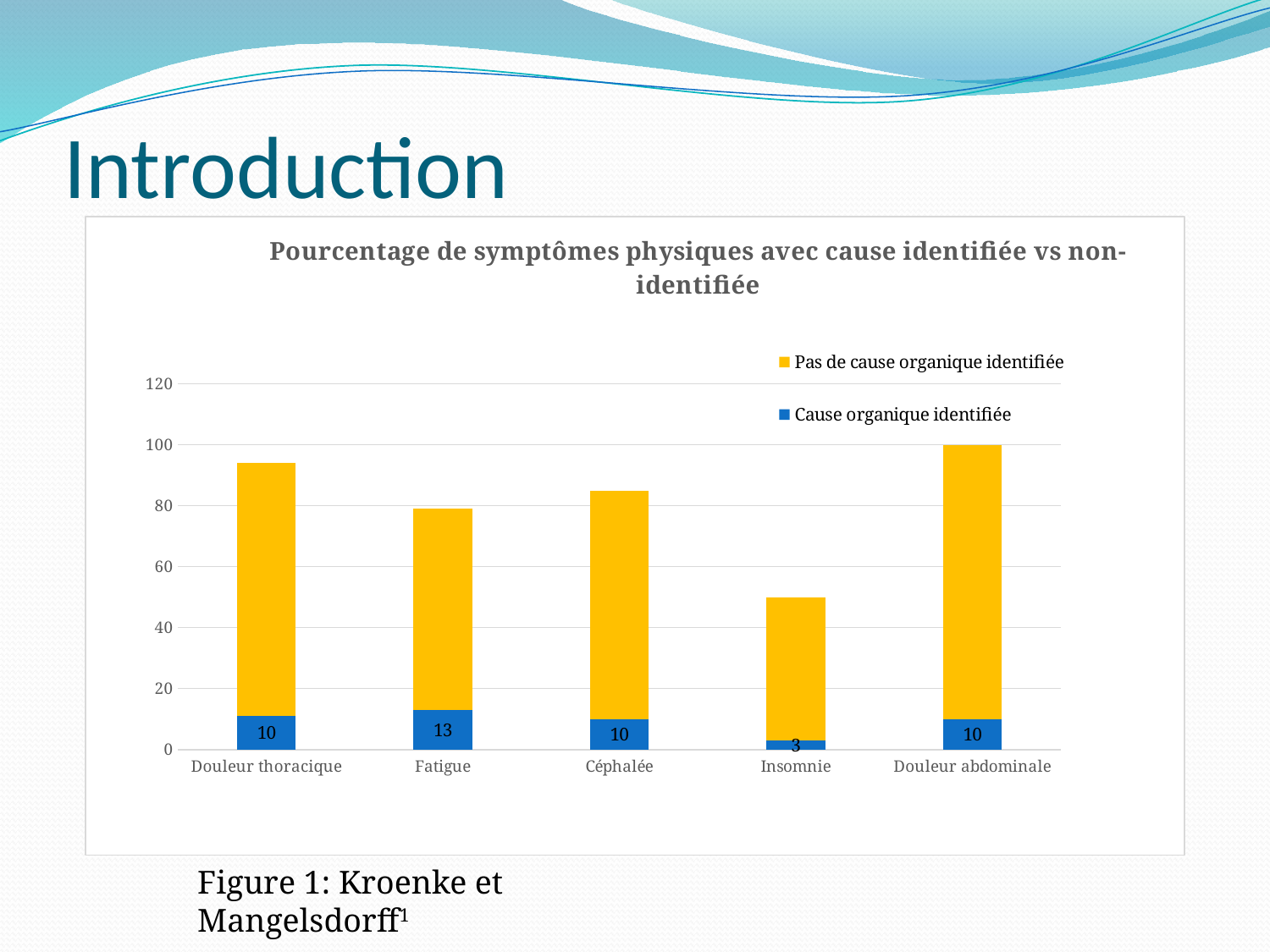
Is the total height of the stacked bar for Insomnie greater or less than 60? less Is the total height of the stacked bar for Douleur thoracique greater or less than 80? greater Which category has the highest value for 'Cause organique identifiée'? Fatigue What is the value of 'Cause organique identifiée' for Fatigue? 13 Which has the larger 'Cause organique identifiée' value, Fatigue or Céphalée? Fatigue What is the value of 'Cause organique identifiée' for Insomnie? 3 What is the difference between the 'Cause organique identifiée' values for Fatigue and Insomnie? 10 Which category has the lowest value for 'Cause organique identifiée'? Insomnie How many symptom categories are shown on the x axis? 5 How many series does the legend list? 2 What is the value of 'Cause organique identifiée' for Douleur abdominale? 10 What kind of chart is shown on the slide? Stacked bar chart